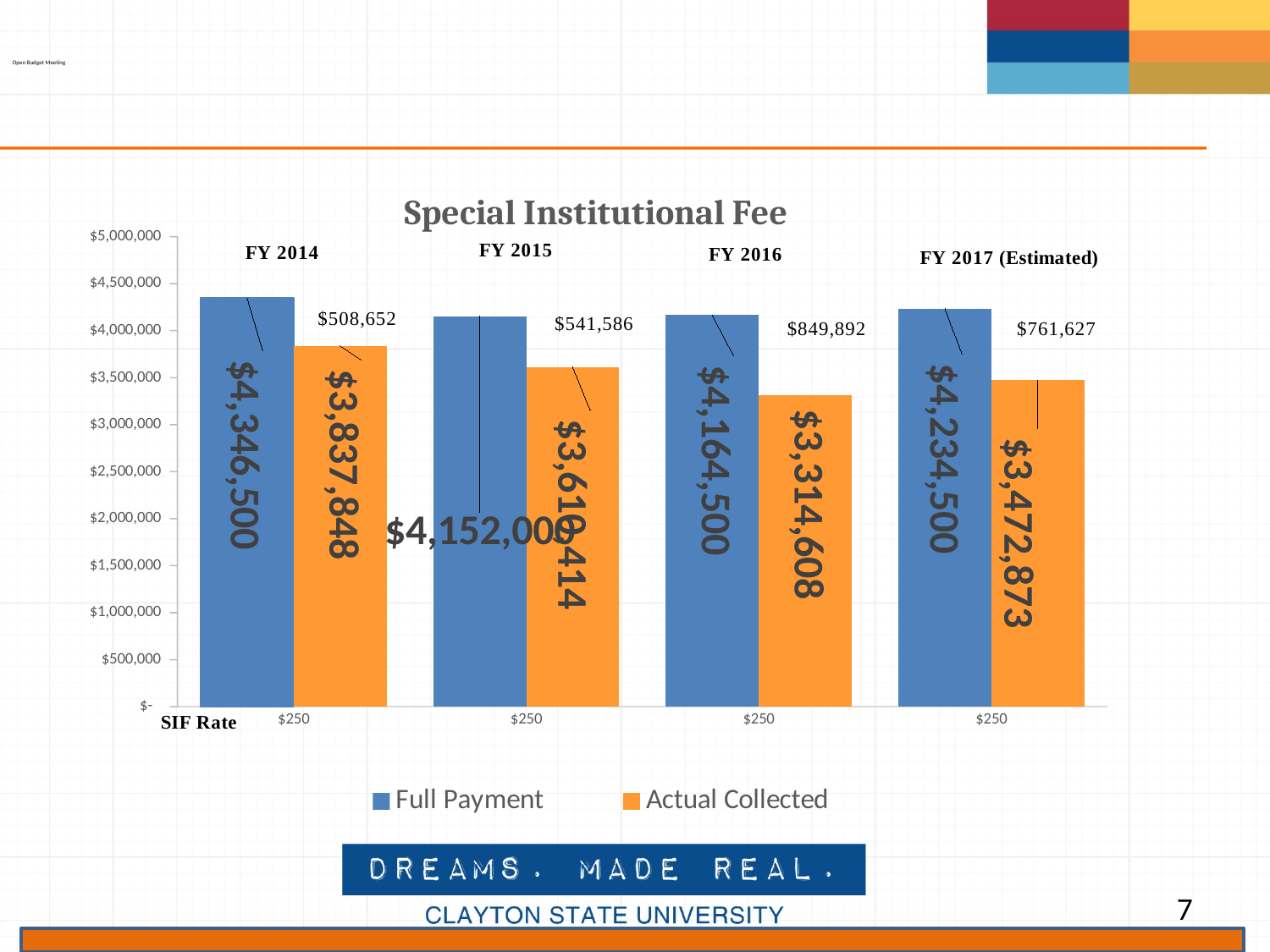
Which is larger, the Full Payment for FY 2016 or the Full Payment for FY 2017 (Estimated)? FY 2017 (Estimated) Which fiscal year has the lowest Actual Collected value? FY 2016 What is the Full Payment value for FY 2014? $4,346,500 Which fiscal year has the highest Full Payment value? FY 2014 How many series does the legend list? 2 What is the difference between Full Payment and Actual Collected in FY 2014? $508,652 What is the Full Payment value for FY 2017 (Estimated)? $4,234,500 Is the Actual Collected value for FY 2015 greater or less than $4,000,000? less What is the Actual Collected value for FY 2017 (Estimated)? $3,472,873 What is the Actual Collected value for FY 2016? $3,314,608 What is the difference between Full Payment and Actual Collected in FY 2016? $849,892 How many fiscal years are shown on the chart? 4